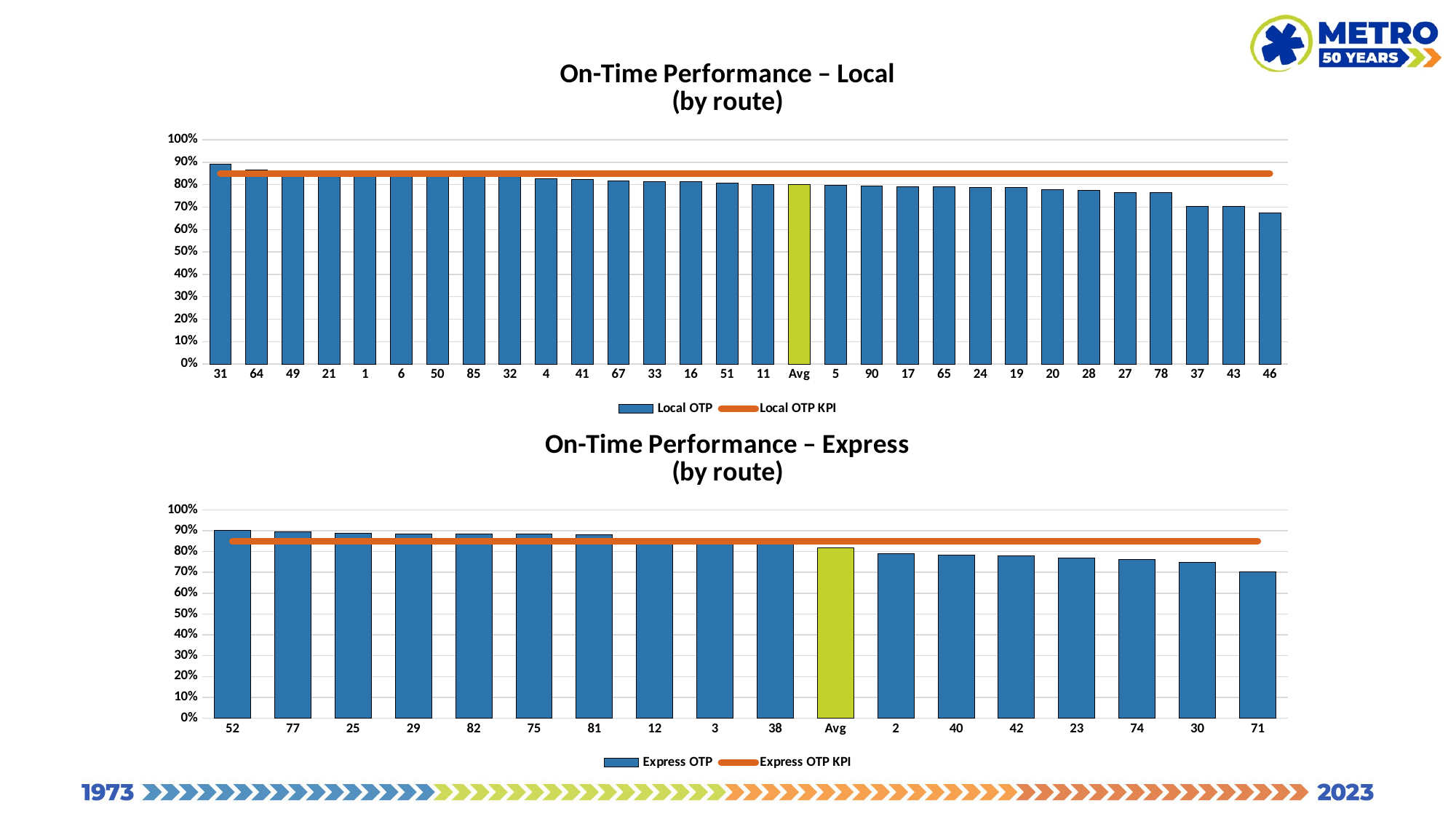
On the On-Time Performance – Express chart, do the bar values rise or fall from left to right? Fall How many entries does the legend of the On-Time Performance – Express chart list? 2 What kind of chart is the On-Time Performance – Local chart? Combination bar and line chart On the On-Time Performance – Express chart, is the value for route 30 greater or less than 80%? less On the On-Time Performance – Local chart, is the value for route 46 greater or less than 70%? less On the On-Time Performance – Local chart, how many bars are plotted, including the Avg bar? 30 On the On-Time Performance – Local chart, which route has the highest on-time performance? 31 On the On-Time Performance – Local chart, which route has the lowest on-time performance? 46 On the On-Time Performance – Express chart, which route has the lowest on-time performance? 71 On the On-Time Performance – Express chart, is the value for route 52 greater or less than 80%? greater On the On-Time Performance – Express chart, how many bars are plotted, including the Avg bar? 18 On the On-Time Performance – Express chart, which route has the highest on-time performance? 52